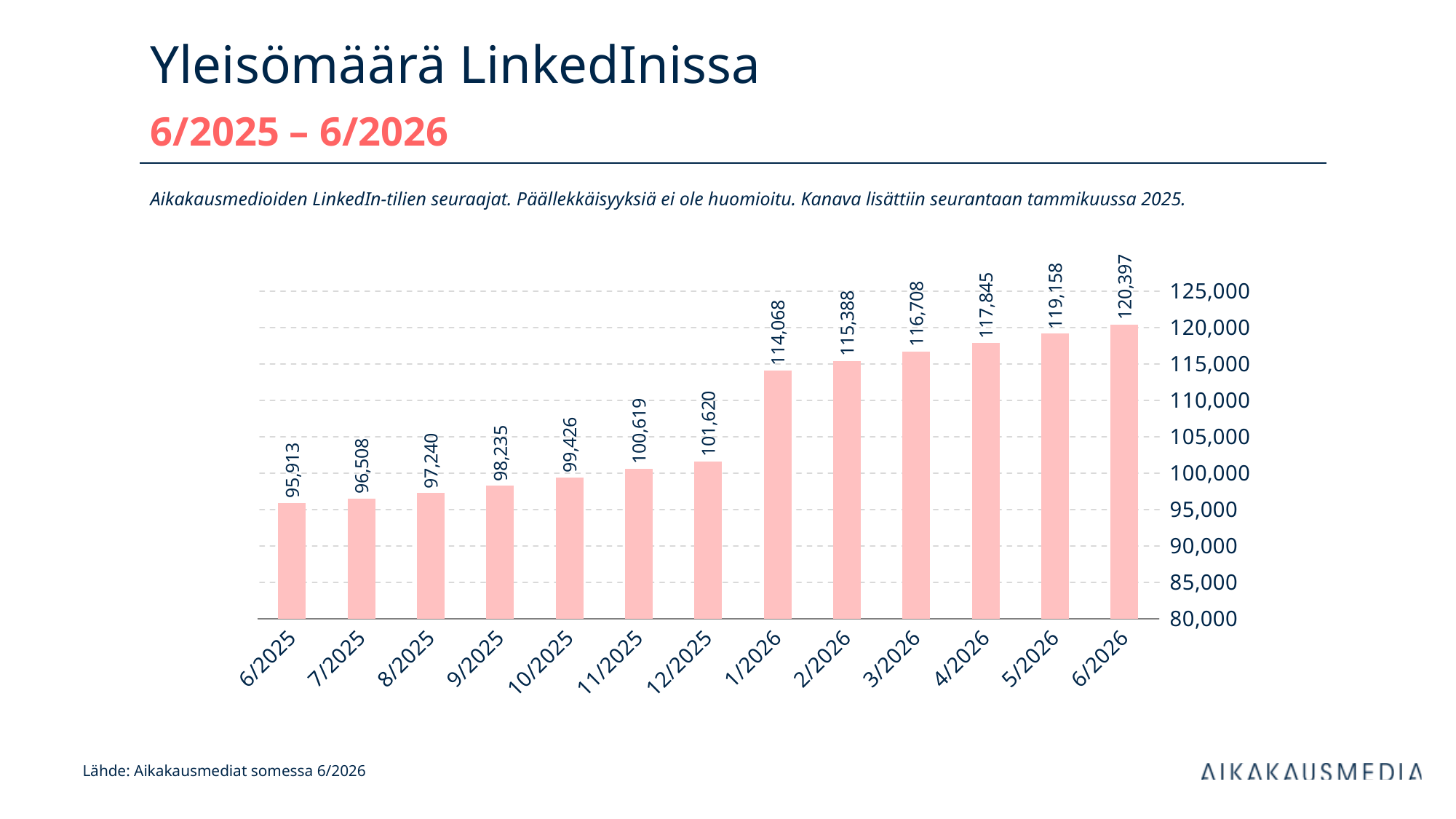
Which month has the highest value? 6/2026 What is the value for 6/2025? 95,913 What is the value for 12/2025? 101,620 What is the value for 1/2026? 114,068 Which month has the lowest value? 6/2025 What is the difference between the values for 6/2026 and 6/2025? 24,484 How many months are shown on the x axis? 13 Do the values rise or fall from 6/2025 to 6/2026? Rise What kind of chart is shown on the slide? Bar chart What is the value for 6/2026? 120,397 Which is larger, the value for 3/2026 or the value for 11/2025? 3/2026 What is the difference between the values for 1/2026 and 12/2025? 12,448